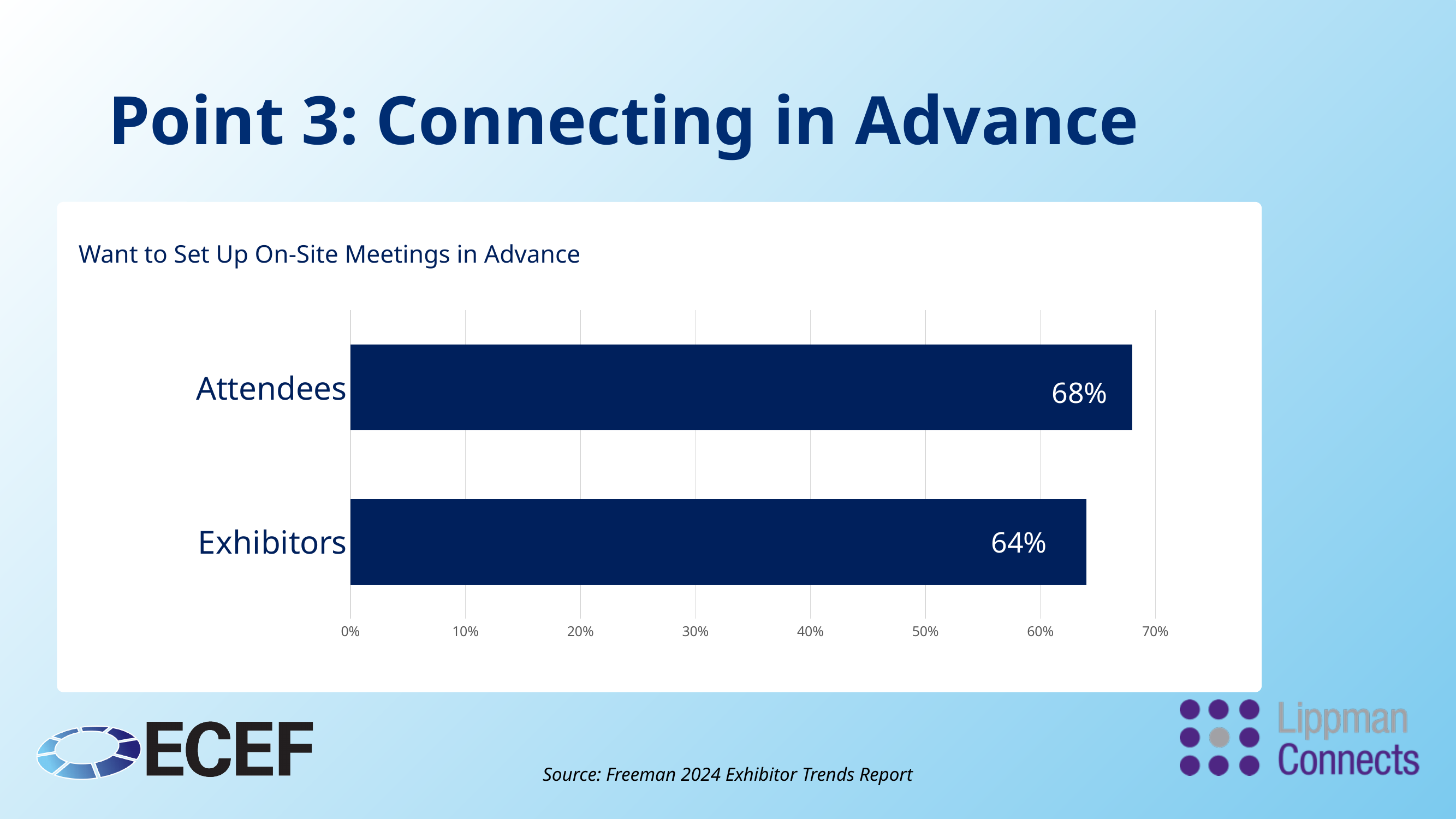
Is the value for Attendees larger or smaller than the value for Exhibitors? larger How many categories are shown in the chart? 2 What kind of chart is shown on the slide? bar chart What is the highest value shown on the chart's x axis? 70% Is the value for Attendees greater or less than 70%? less What percentage of Exhibitors want to set up on-site meetings in advance? 64% What is the title of the chart? Want to Set Up On-Site Meetings in Advance Which category has the lower value in the chart? Exhibitors What is the difference between the Attendees value and the Exhibitors value? 4% What percentage of Attendees want to set up on-site meetings in advance? 68% Which category has the higher value in the chart? Attendees Is the value for Exhibitors greater or less than 60%? greater